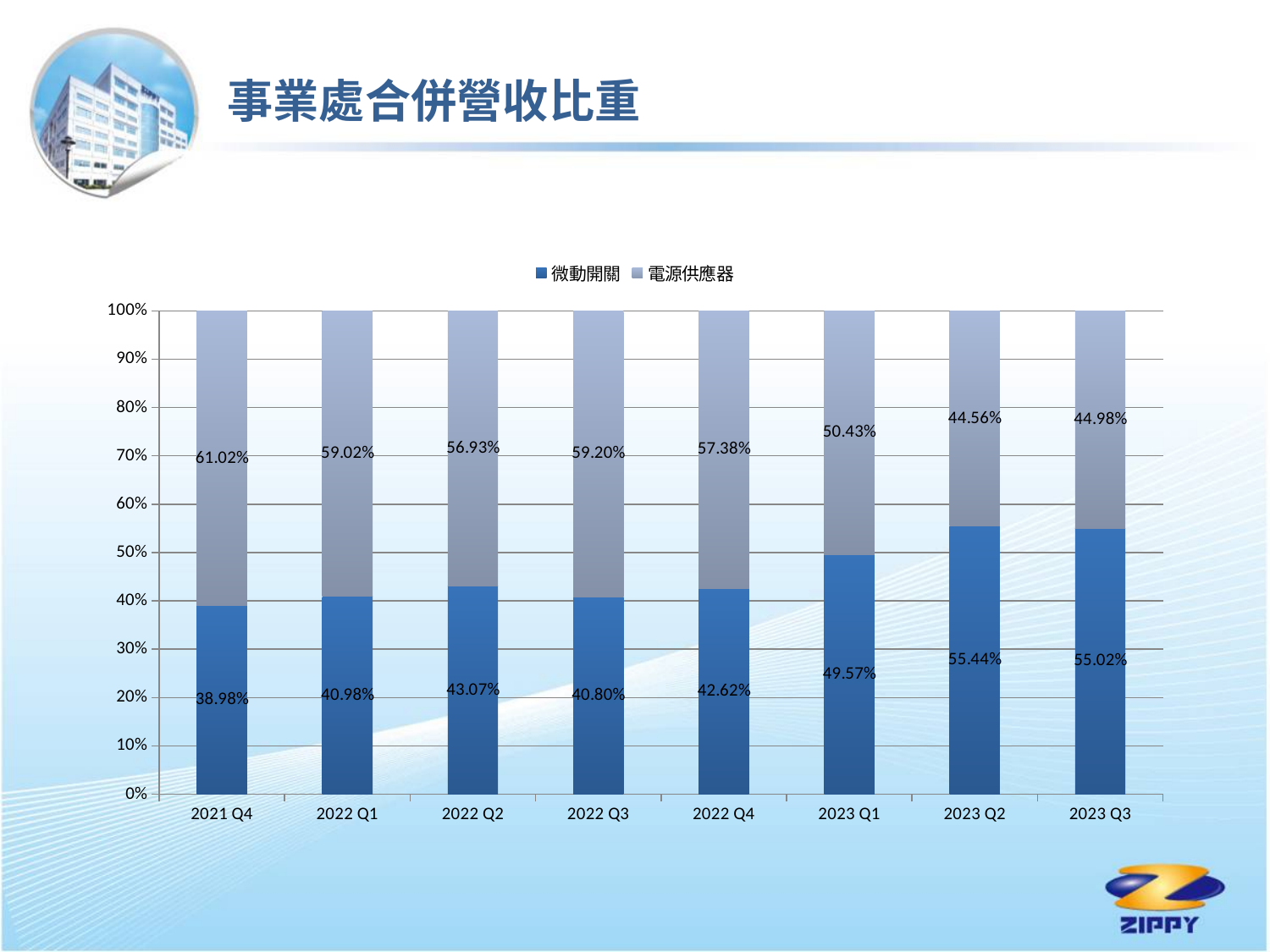
What is the difference between the 電源供應器 value in 2021 Q4 and in 2023 Q3? 16.04% Which quarter has the highest value for 微動開關? 2023 Q2 What is the value for 微動開關 in 2022 Q3? 40.80% Which quarter has the lowest value for 電源供應器? 2023 Q2 What is the value for 電源供應器 in 2021 Q4? 61.02% How many series does the legend list? 2 Which is larger in 2023 Q1: the value for 微動開關 or the value for 電源供應器? 電源供應器 What is the title of the slide? 事業處合併營收比重 What is the value for 微動開關 in 2023 Q2? 55.44% What kind of chart is shown on the slide? Stacked bar chart Does the value for 微動開關 rise or fall from 2022 Q4 to 2023 Q2? Rise How many quarters are shown on the x axis? 8